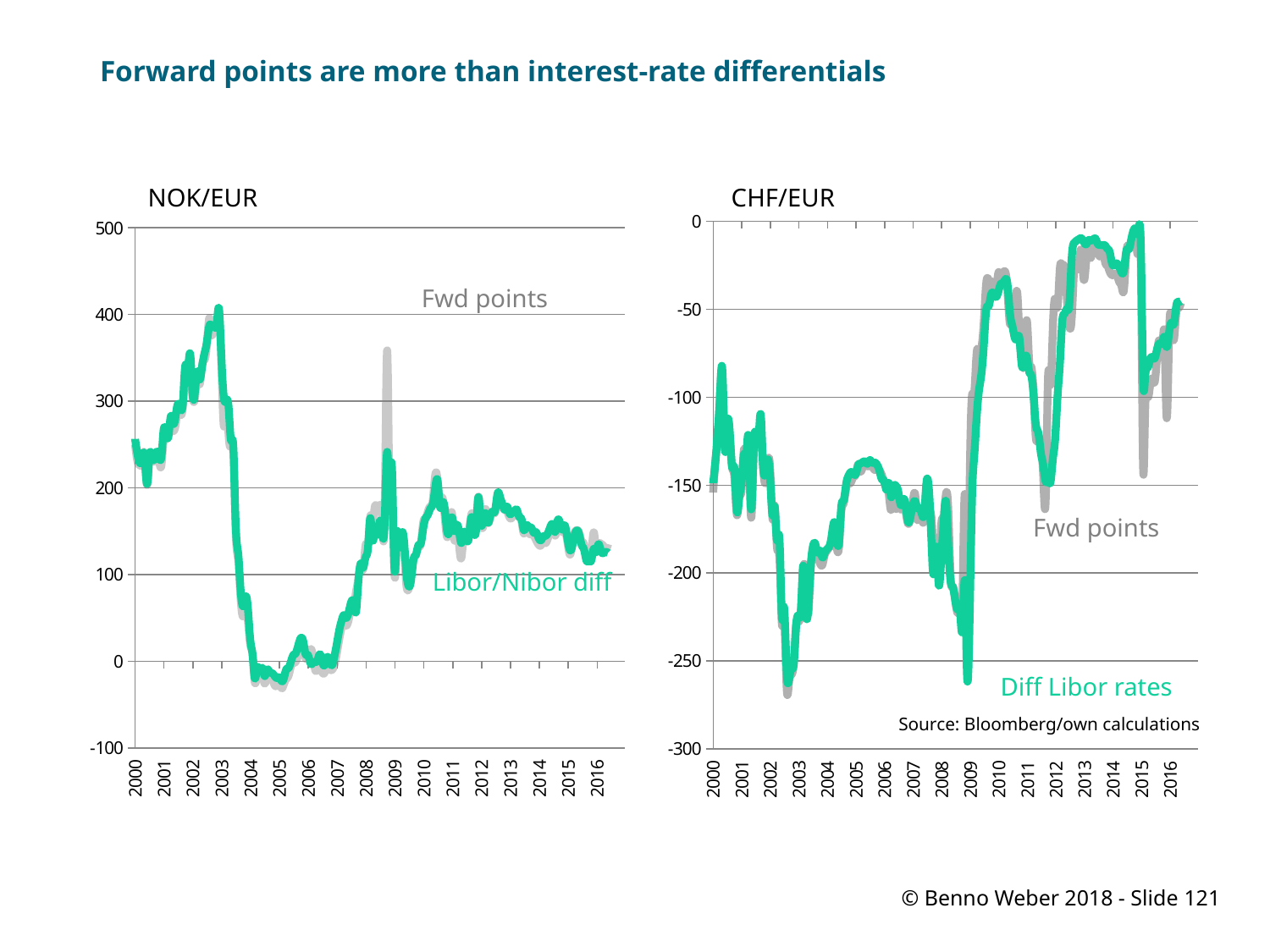
On the CHF/EUR chart, is the value of Diff Libor rates at the start of 2003 greater or less than -200? less On the NOK/EUR chart, what is the name of the green series? Libor/Nibor diff On the NOK/EUR chart, does the Libor/Nibor diff rise or fall between 2003 and 2004? fall How many series are plotted on the NOK/EUR chart? 2 On the CHF/EUR chart, does the Diff Libor rates series rise or fall between 2009 and 2010? rise On the CHF/EUR chart, is the value of Diff Libor rates in 2014 greater or less than -50? greater What kind of chart is the NOK/EUR chart? line chart On the CHF/EUR chart, what is the name of the grey series? Fwd points On the NOK/EUR chart, is the value of Libor/Nibor diff in 2005 greater or less than 100? less What kind of chart is the CHF/EUR chart? line chart